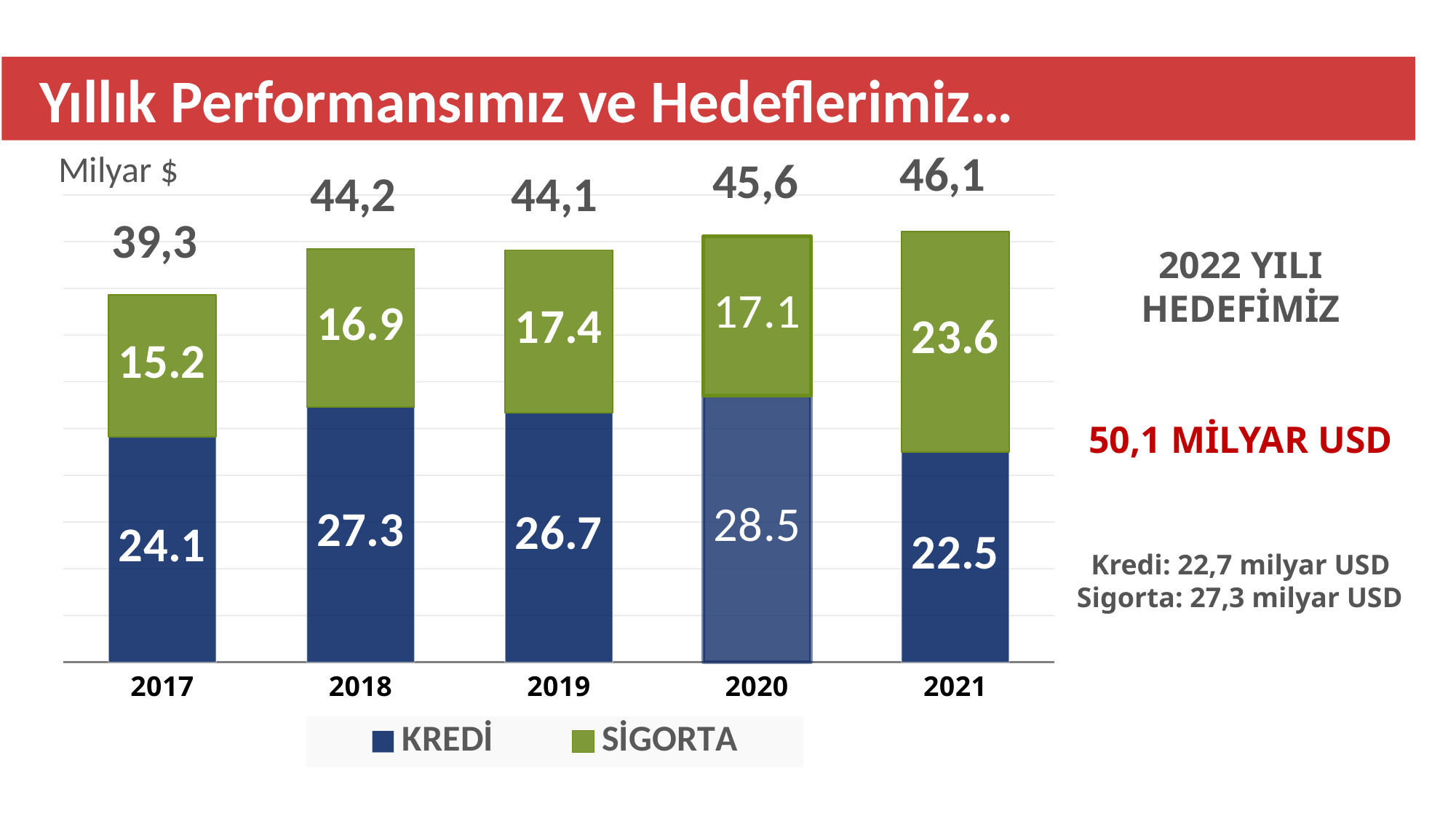
What is the total shown above the 2020 bar? 45,6 What unit label is shown at the top left of the chart? Milyar $ Which year has the lowest total shown above its bar? 2017 What is the KREDİ value for 2018? 27.3 How many series does the legend list? 2 Which year has the lowest SİGORTA value? 2017 Which year has the highest KREDİ value? 2020 Is the KREDİ value larger in 2019 or in 2021? 2019 What is the difference between the SİGORTA values for 2021 and 2020? 6.5 What is the SİGORTA value for 2021? 23.6 How many years are shown on the x axis? 5 What kind of chart is shown on the slide? Stacked bar chart